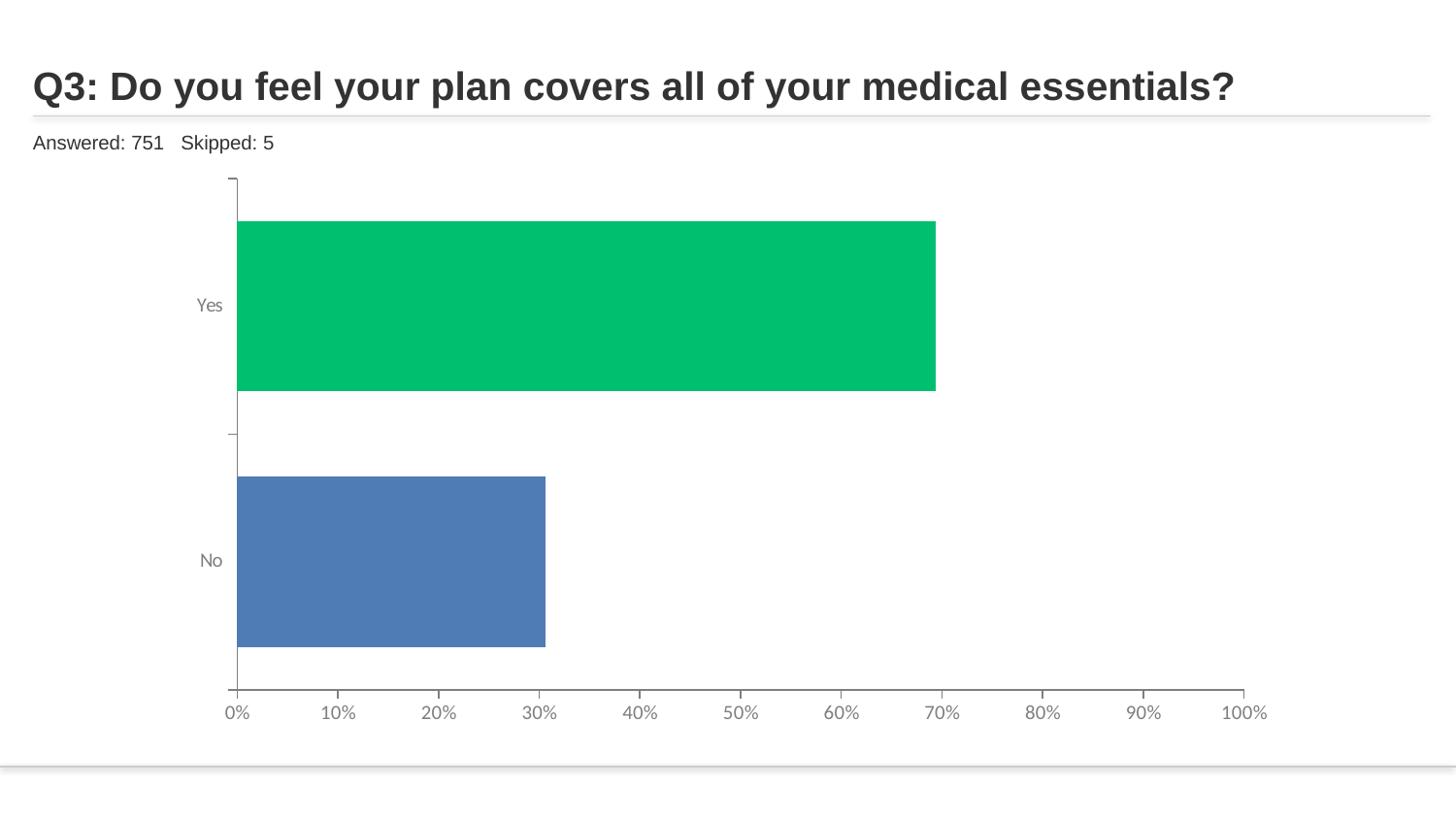
Is the value for Yes greater or less than 80%? less What kind of chart is shown on the slide? bar chart Is the value for No greater or less than 20%? greater Is the value for Yes greater or less than 60%? greater What is the title of the chart? Q3: Do you feel your plan covers all of your medical essentials? Which response category has the highest value? Yes Which is larger, the value for Yes or the value for No? Yes How many response categories are plotted in the chart? 2 Which response category has the lowest value? No How many respondents answered the question according to the slide? 751